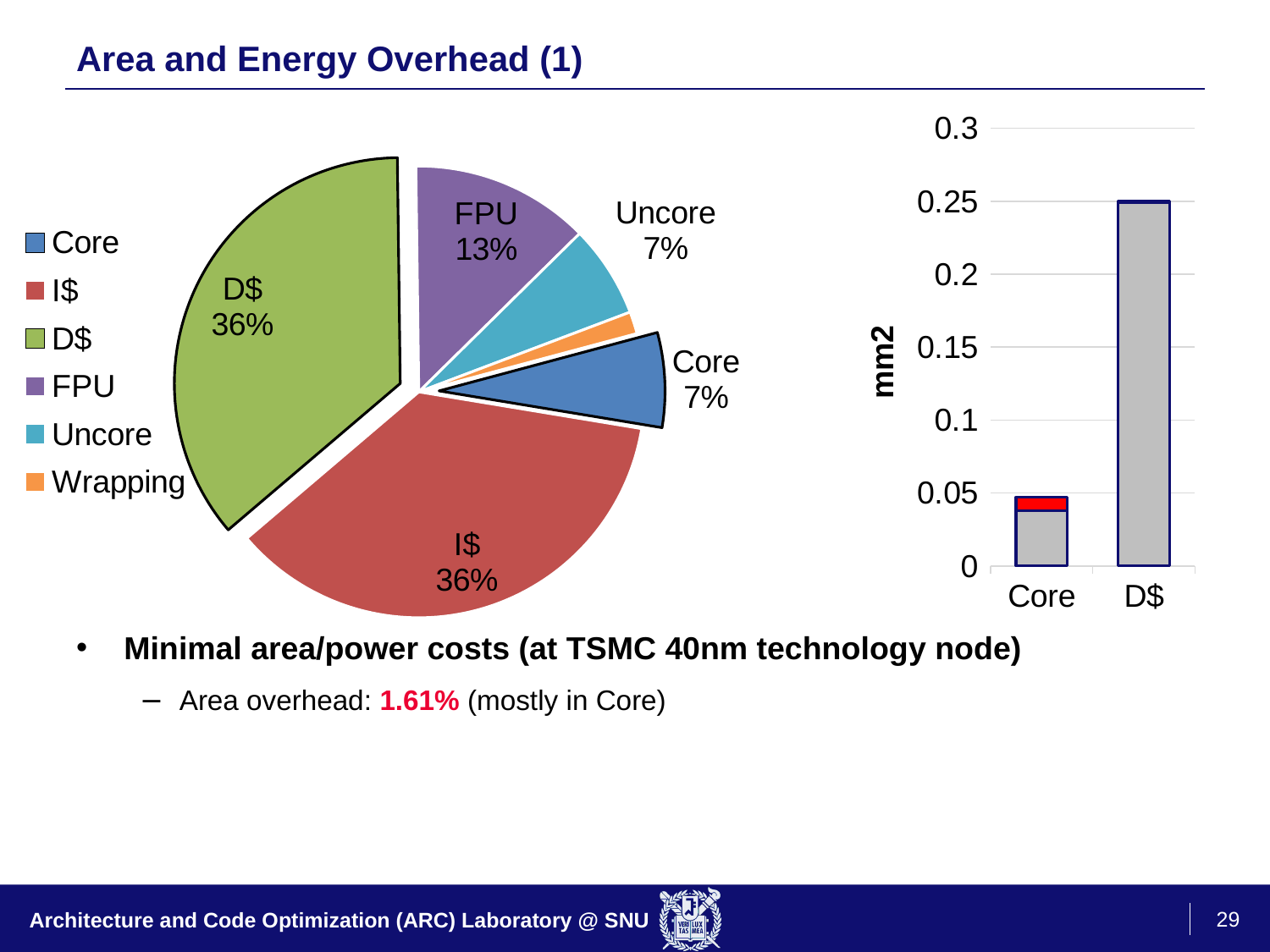
In the pie chart on the left, what percentage is labelled for Uncore? 7% What kind of chart is the chart on the right of the slide? Bar chart How many categories does the legend of the pie chart on the left list? 6 In the bar chart on the right, which category has the taller bar, Core or D$? D$ In the bar chart on the right, what is the value for D$? 0.25 In the pie chart on the left, what percentage is labelled for D$? 36% In the pie chart on the left, what percentage is labelled for FPU? 13% In the pie chart on the left, which slice is larger, FPU or Core? FPU In the bar chart on the right, is the value for Core greater or less than 0.1? less In the pie chart on the left, what is the difference in percentage points between the I$ slice and the FPU slice? 23 In the pie chart on the left, which slice is the smallest? Wrapping What is the y-axis label of the bar chart on the right? mm2